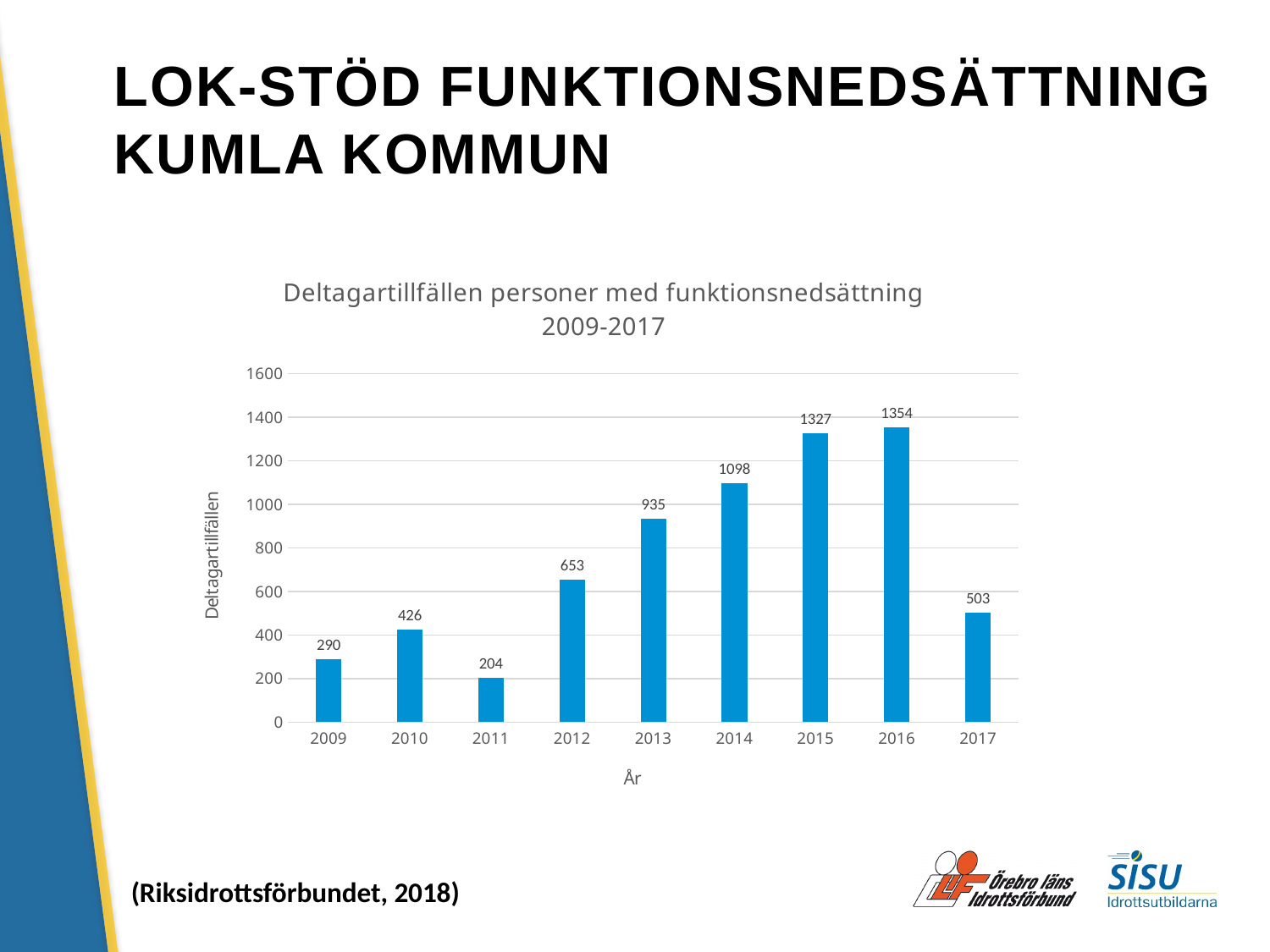
Do the values rise or fall from 2011 to 2016? rise What is the value for 2017? 503 What is the title of the chart? Deltagartillfällen personer med funktionsnedsättning 2009-2017 Is the value for 2012 greater or less than 600? greater What is the value for 2013? 935 Which year has the highest value? 2016 What is the difference between the values for 2016 and 2015? 27 What kind of chart is shown on the slide? bar chart How many years are shown on the x axis? 9 Which is larger, the value for 2010 or the value for 2017? 2017 Which year has the lowest value? 2011 What is the difference between the values for 2014 and 2009? 808